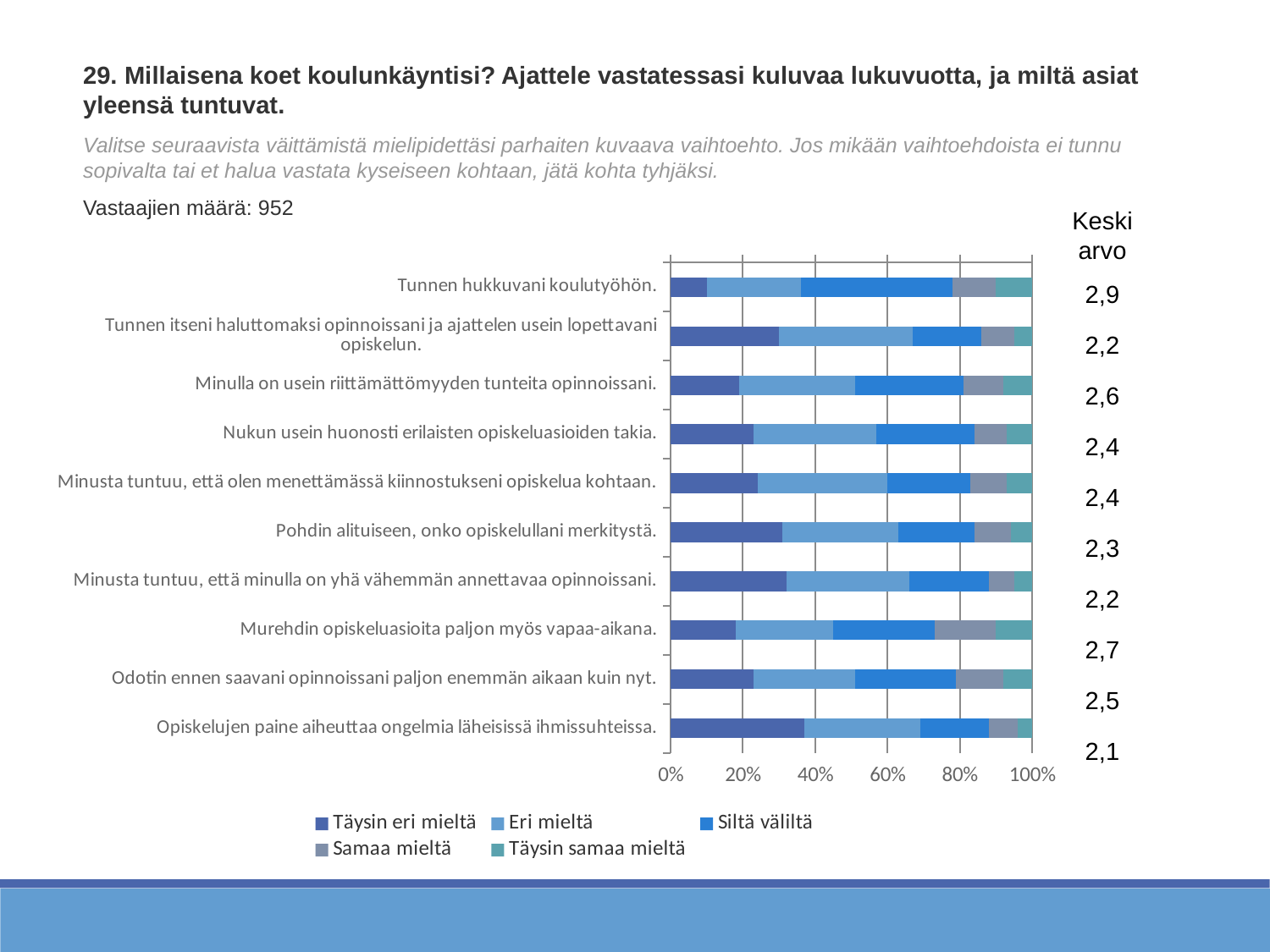
What is the Keski arvo shown for "Opiskelujen paine aiheuttaa ongelmia läheisissä ihmissuhteissa."? 2,1 Is the "Täysin eri mieltä" share for "Opiskelujen paine aiheuttaa ongelmia läheisissä ihmissuhteissa." greater or less than 20%? greater How many series does the legend list? 5 How many respondents (Vastaajien määrä) does the slide report? 952 What is the difference between the highest Keski arvo (2,9) and the lowest Keski arvo (2,1)? 0,8 What is the Keski arvo (mean) shown for "Tunnen hukkuvani koulutyöhön."? 2,9 What kind of chart is shown on the slide? bar chart Which statement has the lowest Keski arvo? Opiskelujen paine aiheuttaa ongelmia läheisissä ihmissuhteissa. Which has the larger Keski arvo: "Murehdin opiskeluasioita paljon myös vapaa-aikana." or "Nukun usein huonosti erilaisten opiskeluasioiden takia."? Murehdin opiskeluasioita paljon myös vapaa-aikana. How many statements (categories) are plotted in the chart? 10 What is the Keski arvo shown for "Murehdin opiskeluasioita paljon myös vapaa-aikana."? 2,7 Which statement has the highest Keski arvo? Tunnen hukkuvani koulutyöhön.